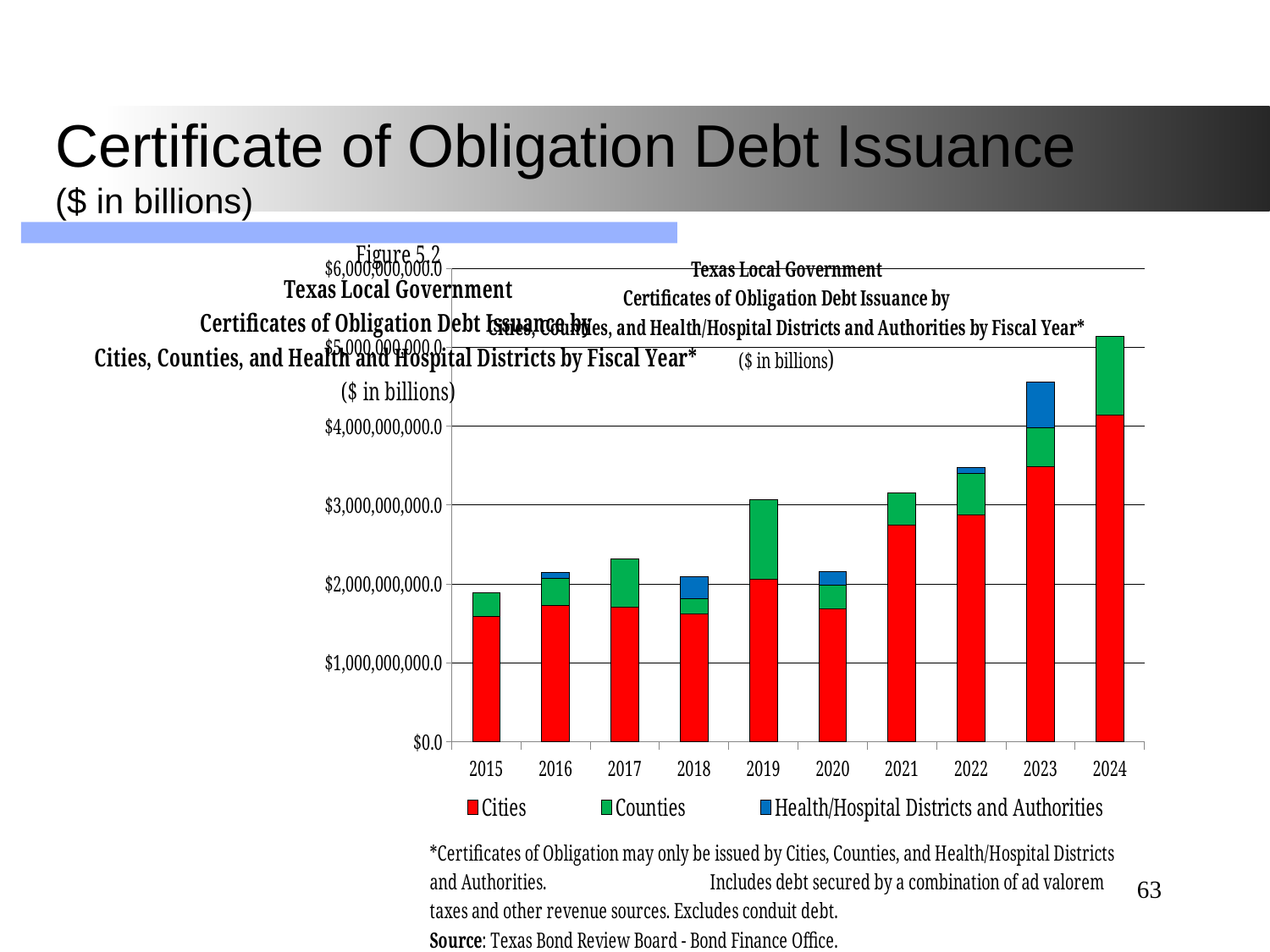
Is the Cities value for 2023 greater or less than $3,000,000,000.0? greater How many fiscal years are shown on the x axis of the chart? 10 Which fiscal year has the highest total Certificate of Obligation debt issuance? 2024 Is the total stacked bar for 2024 greater or less than $5,000,000,000.0? greater Which colour represents the Cities series in the chart? Red Which fiscal year has the lowest total Certificate of Obligation debt issuance? 2015 How many series does the chart's legend list? 3 Is the Cities value for 2015 greater or less than $1,000,000,000.0? greater What kind of chart is shown on the slide? Stacked bar chart Which is larger, the Cities value for 2024 or the Cities value for 2023? 2024 Do the total stacked bars rise or fall from 2021 to 2024? Rise